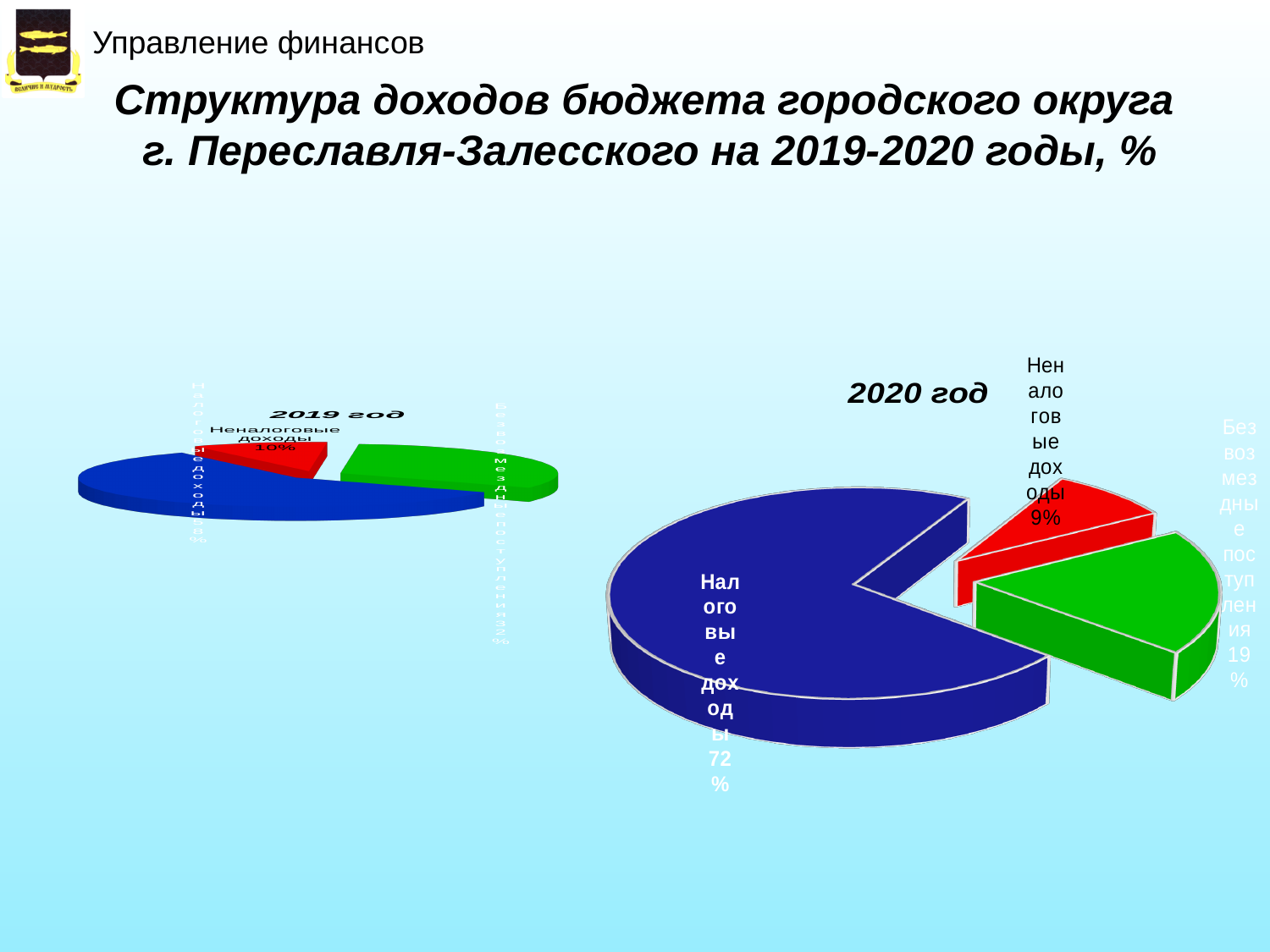
In the 2019 год chart, which colour slice is the largest? Blue In the 2020 год chart, which category has the largest slice? Налоговые доходы In the 2020 год chart, which is larger: Безвозмездные поступления or Неналоговые доходы? Безвозмездные поступления In the 2020 год chart, what share is shown for Безвозмездные поступления? 19% In the 2019 год chart, what share is shown for Неналоговые доходы? 10% How many pie charts are shown on the slide? 2 In the 2020 год chart, by how many percentage points does Налоговые доходы exceed Безвозмездные поступления? 53 In the 2020 год chart, what share is shown for Налоговые доходы? 72% What type of chart is the 2020 год chart? Pie chart In the 2020 год chart, what share is shown for Неналоговые доходы? 9% How many slices does the 2020 год chart have? 3 In the 2020 год chart, which category has the smallest slice? Неналоговые доходы